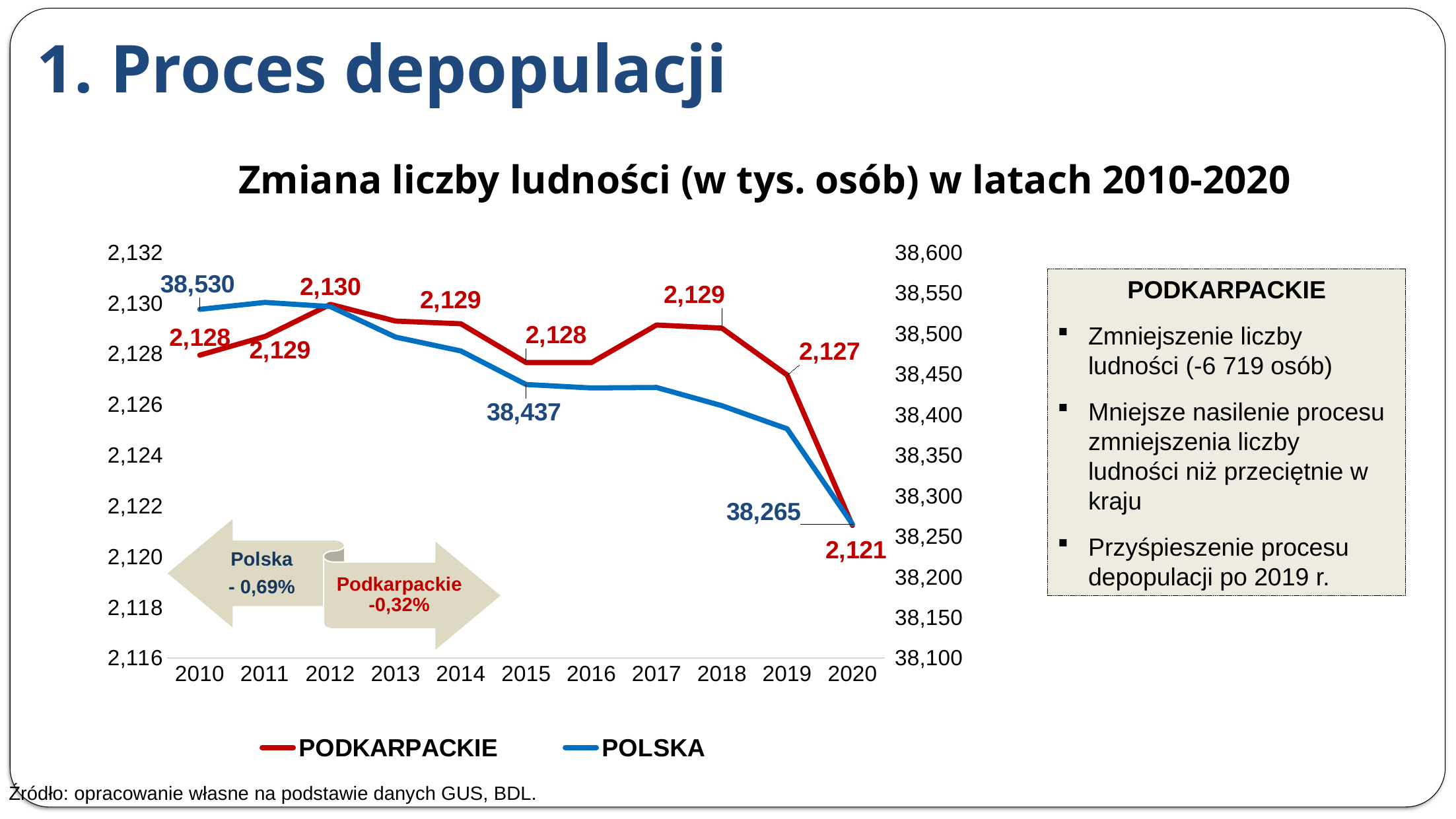
How many series does the legend list? 2 How many years are plotted along the x axis? 11 What kind of chart is shown on the slide? line chart Do the values for POLSKA rise or fall overall from 2010 to 2020? fall What is the value for POLSKA in 2015? 38,437 What is the value for POLSKA in 2010? 38,530 What is the value for POLSKA in 2020? 38,265 By how much did the POLSKA value fall between 2010 and 2020? 265 What is the value for PODKARPACKIE in 2012? 2,130 In which year does the PODKARPACKIE series reach its lowest value? 2020 What is the value for PODKARPACKIE in 2019? 2,127 What is the value for PODKARPACKIE in 2020? 2,121